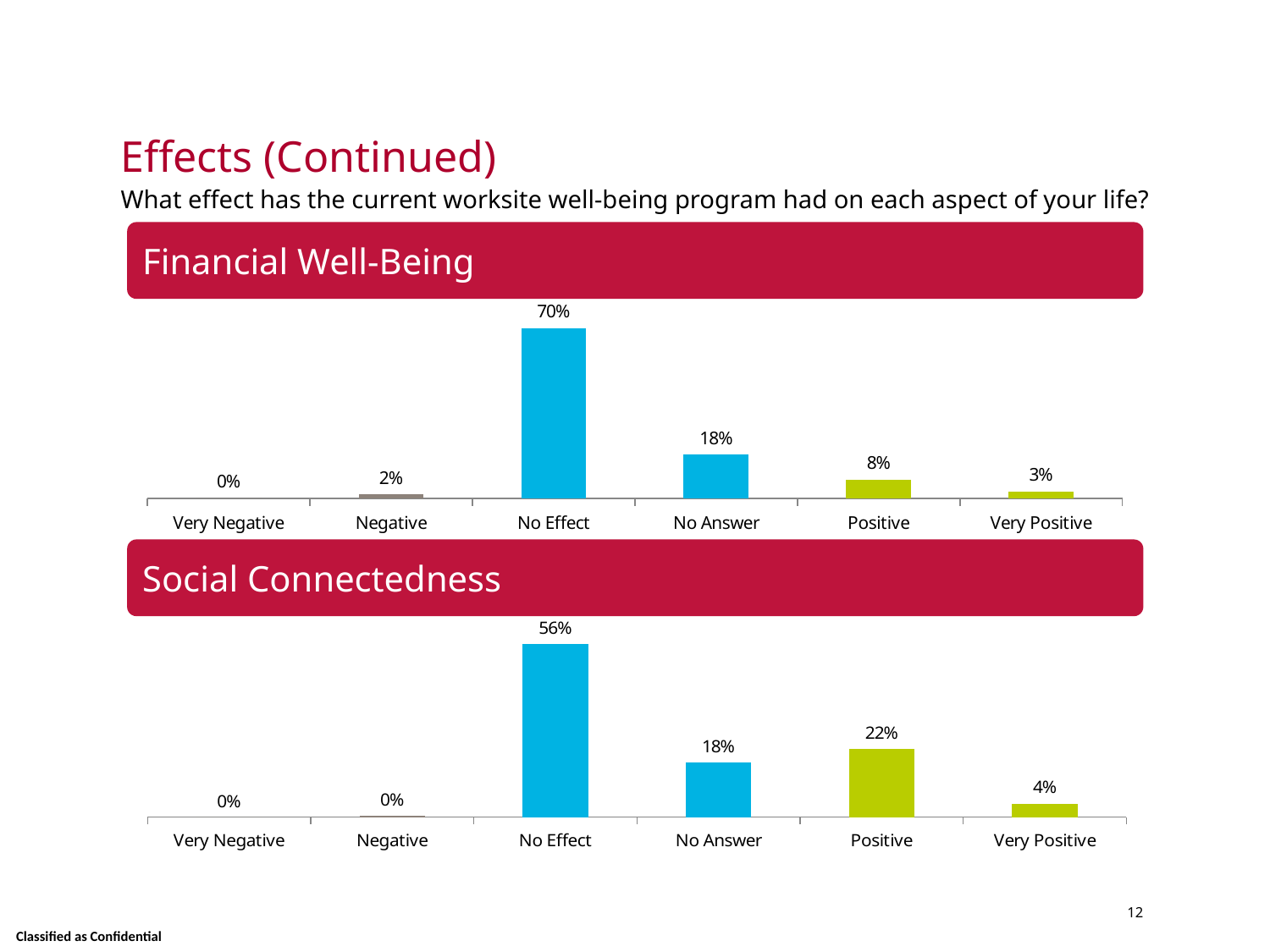
In the Social Connectedness chart, what is the difference between No Effect and No Answer? 38% In the Financial Well-Being chart, which category has the lowest value? Very Negative How many categories are shown on the x axis of the Financial Well-Being chart? 6 In the Financial Well-Being chart, which category has the highest value? No Effect In the Social Connectedness chart, what is the value for Very Positive? 4% In the Social Connectedness chart, what is the value for Positive? 22% What is the title of the top chart on the slide? Financial Well-Being In the Financial Well-Being chart, what is the value for No Effect? 70% What kind of chart is the Social Connectedness chart? Bar chart In the Social Connectedness chart, which is larger, Positive or No Answer? Positive In the Financial Well-Being chart, what is the value for Positive? 8% In the Financial Well-Being chart, what is the difference between No Answer and Positive? 10%